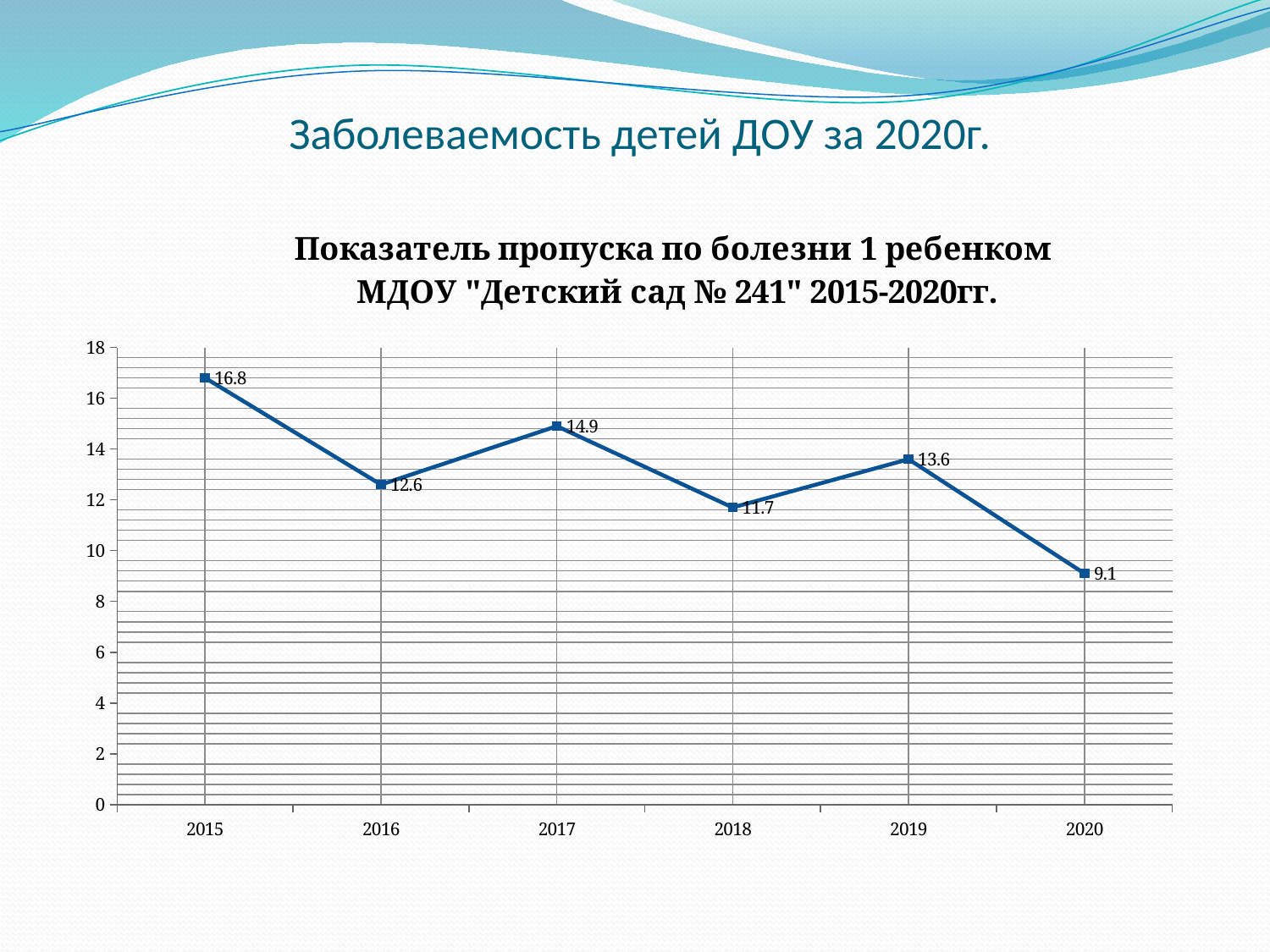
Which is larger, the value for 2017 or the value for 2019? 2017 What is the difference between the values for 2015 and 2020? 7.7 How many years are plotted on the chart? 6 What is the value for 2020? 9.1 Does the value rise or fall from 2019 to 2020? fall Is the value for 2019 greater or less than 12? greater What is the value for 2018? 11.7 What kind of chart is shown on the slide? line chart What is the difference between the values for 2017 and 2016? 2.3 What is the value for 2015? 16.8 Which year has the lowest value? 2020 Which year has the highest value? 2015